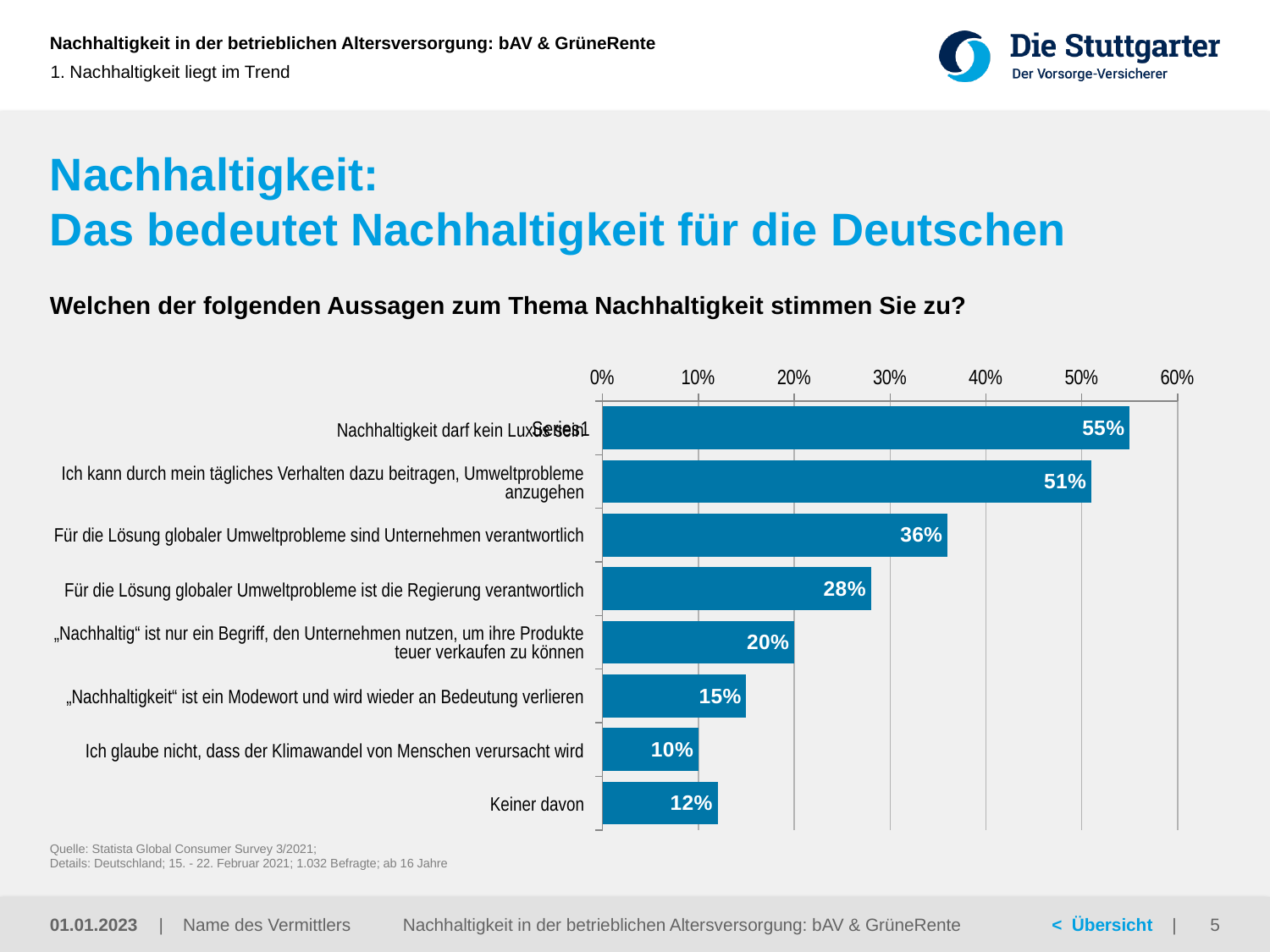
How many statements (categories) are shown in the chart? 8 What is the value for "Keiner davon"? 12% Is the value for "Ich glaube nicht, dass der Klimawandel von Menschen verursacht wird" greater or less than 20%? less Which is larger: the value for "„Nachhaltigkeit“ ist ein Modewort und wird wieder an Bedeutung verlieren" or the value for "Keiner davon"? „Nachhaltigkeit“ ist ein Modewort und wird wieder an Bedeutung verlieren What is the value for "Für die Lösung globaler Umweltprobleme ist die Regierung verantwortlich"? 28% What kind of chart is shown on the slide? Bar chart What is the value for "Ich kann durch mein tägliches Verhalten dazu beitragen, Umweltprobleme anzugehen"? 51% Which statement has the lowest value in the chart? Ich glaube nicht, dass der Klimawandel von Menschen verursacht wird What is the highest value shown in the chart? 55% What is the difference between the value for "Unternehmen verantwortlich" and the value for "Regierung verantwortlich"? 8 percentage points What percentage agreed with "Für die Lösung globaler Umweltprobleme sind Unternehmen verantwortlich"? 36% What is the value shown on the top bar of the chart? 55%